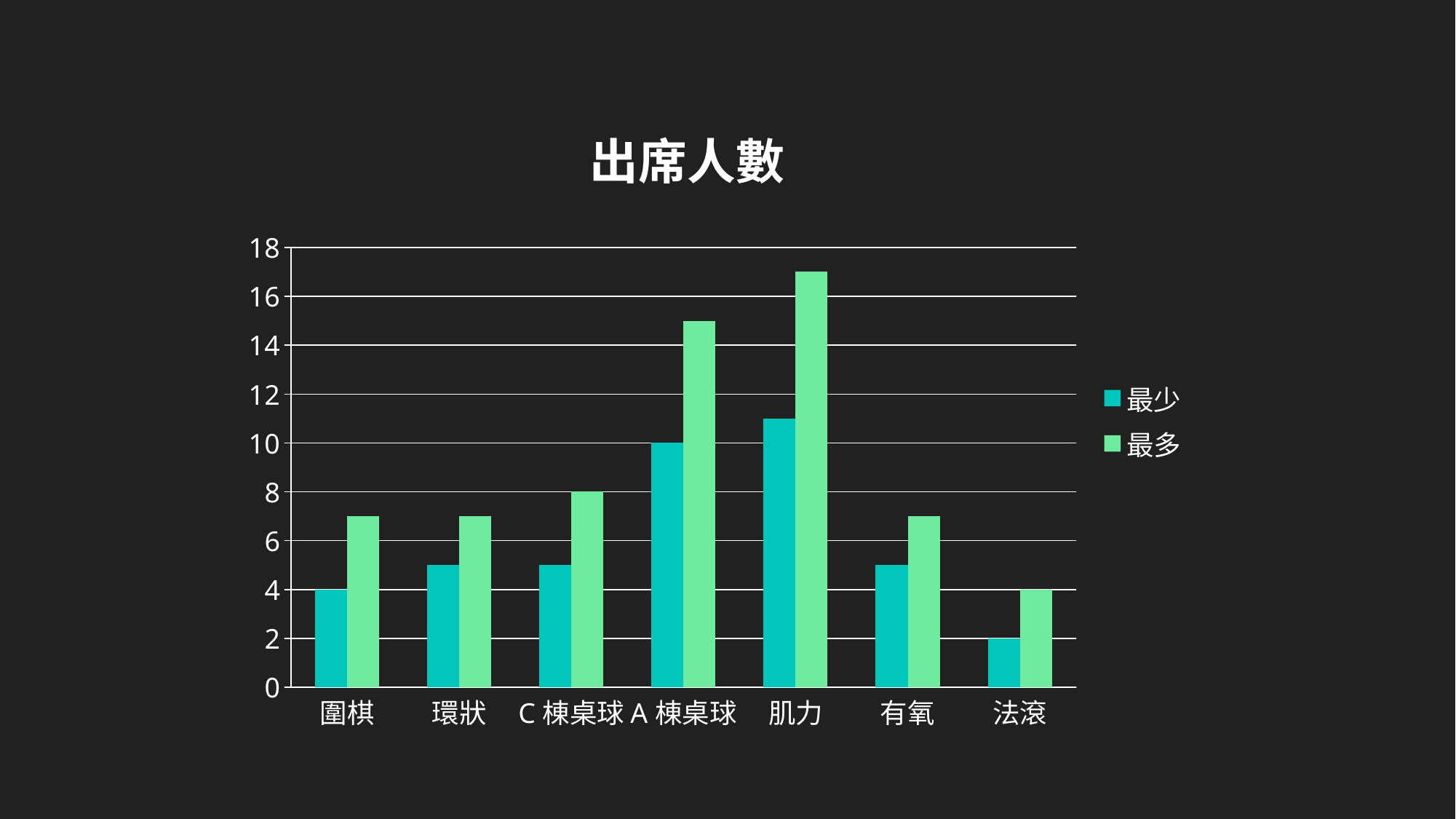
What is the 最少 value for A 棟桌球? 10 What is the 最多 value for C 棟桌球? 8 Which category has the highest 最多 value? 肌力 What is the difference between the 最多 and 最少 values for 法滾? 2 Which category has the lowest 最少 value? 法滾 Is the 最多 value for 肌力 greater or less than 16? greater How many categories are shown on the x axis? 7 What kind of chart is shown on the slide? bar chart What is the 最多 value for 法滾? 4 How many series does the legend list? 2 What is the 最少 value for 圍棋? 4 What is the title of the chart? 出席人數